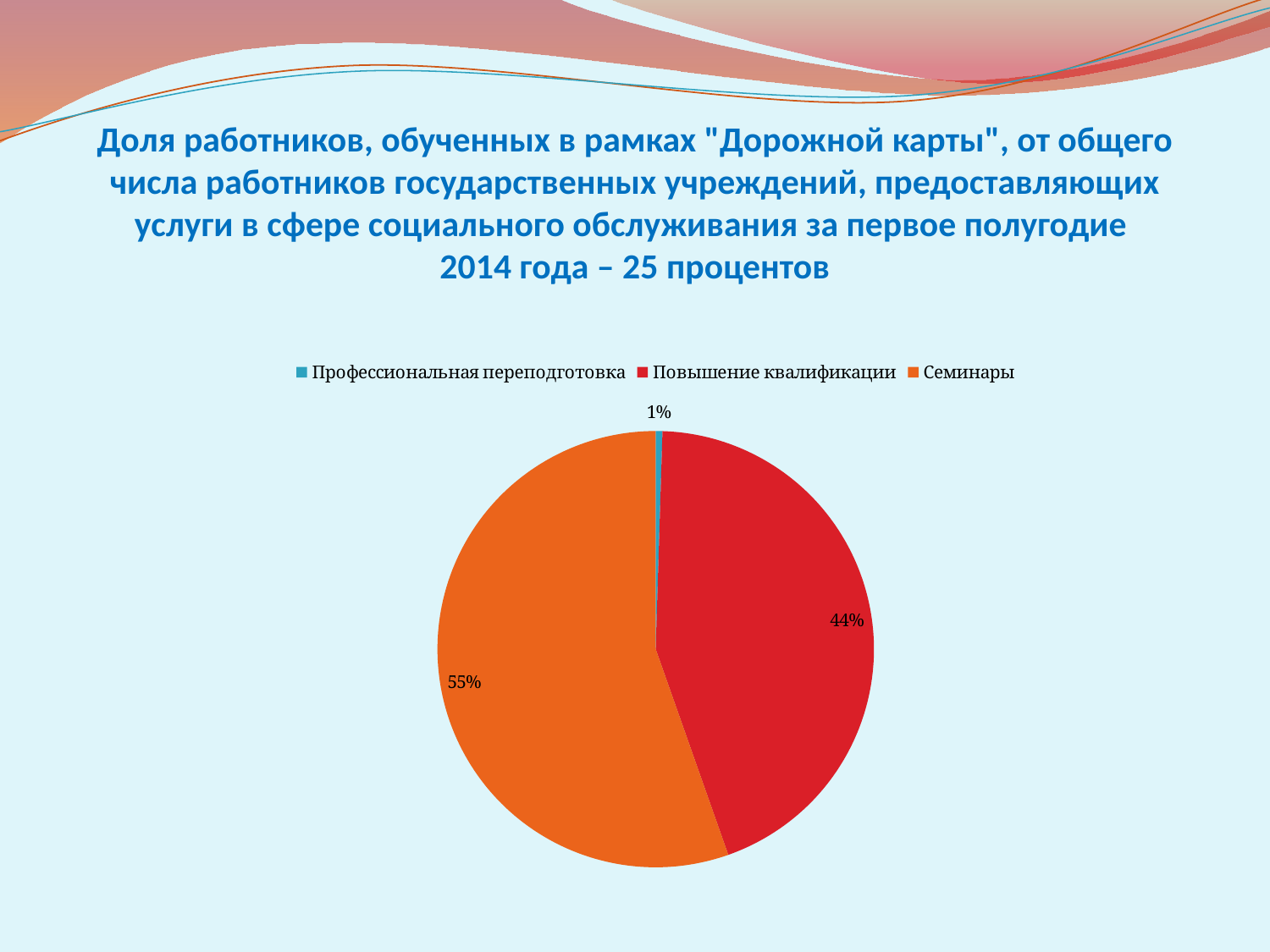
What share of the pie does Профессиональная переподготовка take? 1% What kind of chart is shown on the slide? pie chart How many entries does the legend list? 3 How many categories does the pie chart have? 3 What colour is the slice for Семинары? orange Which category has the largest slice of the pie? Семинары Where is the legend positioned relative to the pie? above the pie What is the difference in percentage points between Семинары and Повышение квалификации? 11 What share of the pie does Повышение квалификации take? 44% What share of the pie does Семинары take? 55% Which is larger, the slice for Повышение квалификации or the slice for Профессиональная переподготовка? Повышение квалификации Which category has the smallest slice of the pie? Профессиональная переподготовка